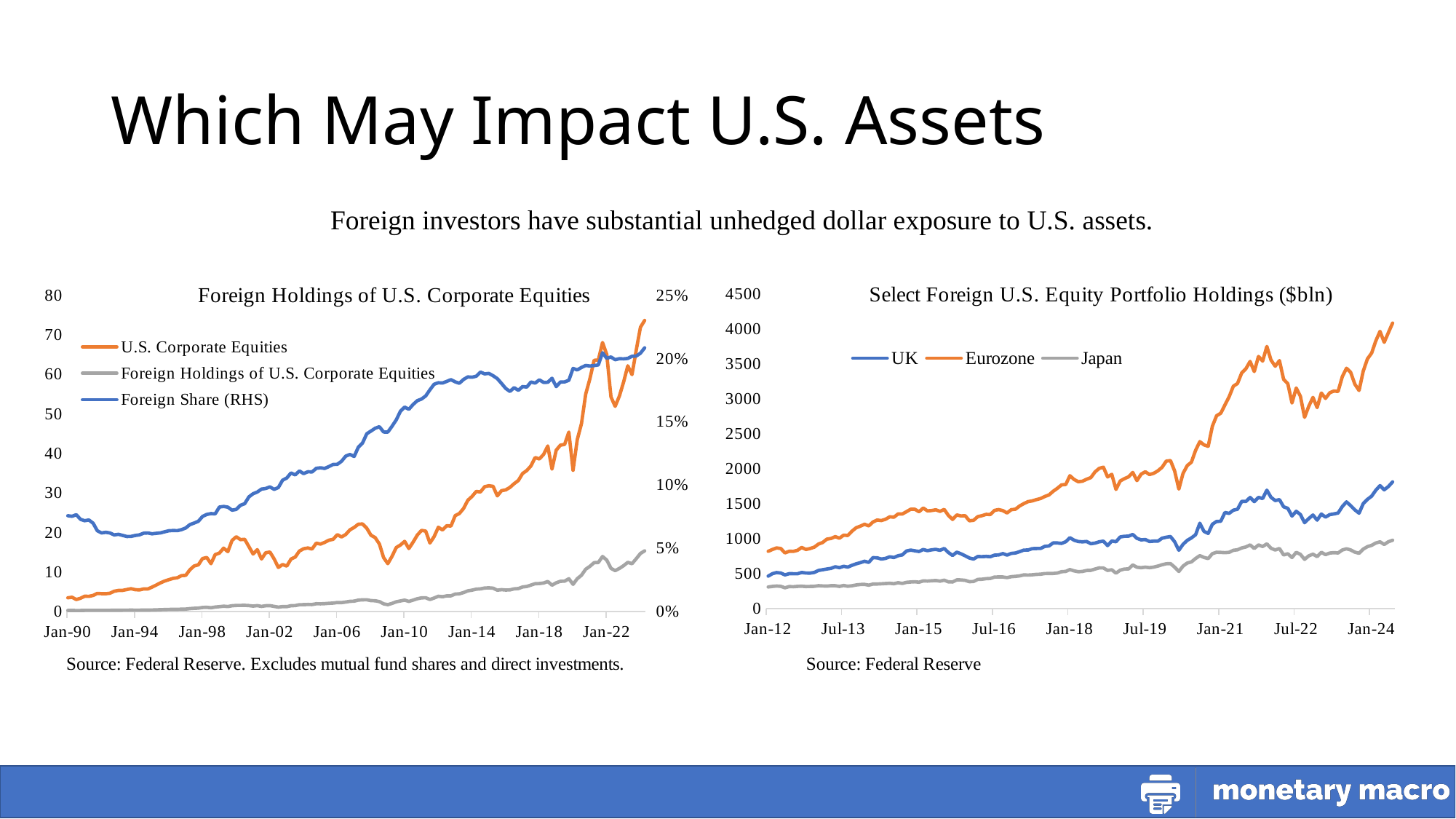
In the chart titled "Foreign Holdings of U.S. Corporate Equities", does the Foreign Share (RHS) series generally rise or fall from Jan-90 to Jan-22? rise What kind of chart is the chart titled "Select Foreign U.S. Equity Portfolio Holdings ($bln)"? line chart In the chart titled "Foreign Holdings of U.S. Corporate Equities", which series is plotted on the right-hand axis according to the legend? Foreign Share (RHS) In the chart titled "Select Foreign U.S. Equity Portfolio Holdings ($bln)", which is larger at Jan-15, UK or Japan? UK In the chart titled "Foreign Holdings of U.S. Corporate Equities", is the Foreign Share (RHS) value at Jan-14 greater or less than 15%? greater In the chart titled "Select Foreign U.S. Equity Portfolio Holdings ($bln)", which series has the highest value at Jan-24? Eurozone How many series does the legend list in the chart titled "Select Foreign U.S. Equity Portfolio Holdings ($bln)"? 3 How many series does the legend list in the chart titled "Foreign Holdings of U.S. Corporate Equities"? 3 In the chart titled "Select Foreign U.S. Equity Portfolio Holdings ($bln)", is the Eurozone value at Jan-24 greater or less than 3500? greater In the chart titled "Select Foreign U.S. Equity Portfolio Holdings ($bln)", does the Eurozone series generally rise or fall from Jan-12 to Jan-24? rise In the chart titled "Select Foreign U.S. Equity Portfolio Holdings ($bln)", is the Japan value at Jan-24 greater or less than 1000? less In the chart titled "Select Foreign U.S. Equity Portfolio Holdings ($bln)", which series has the lowest value at Jan-24? Japan